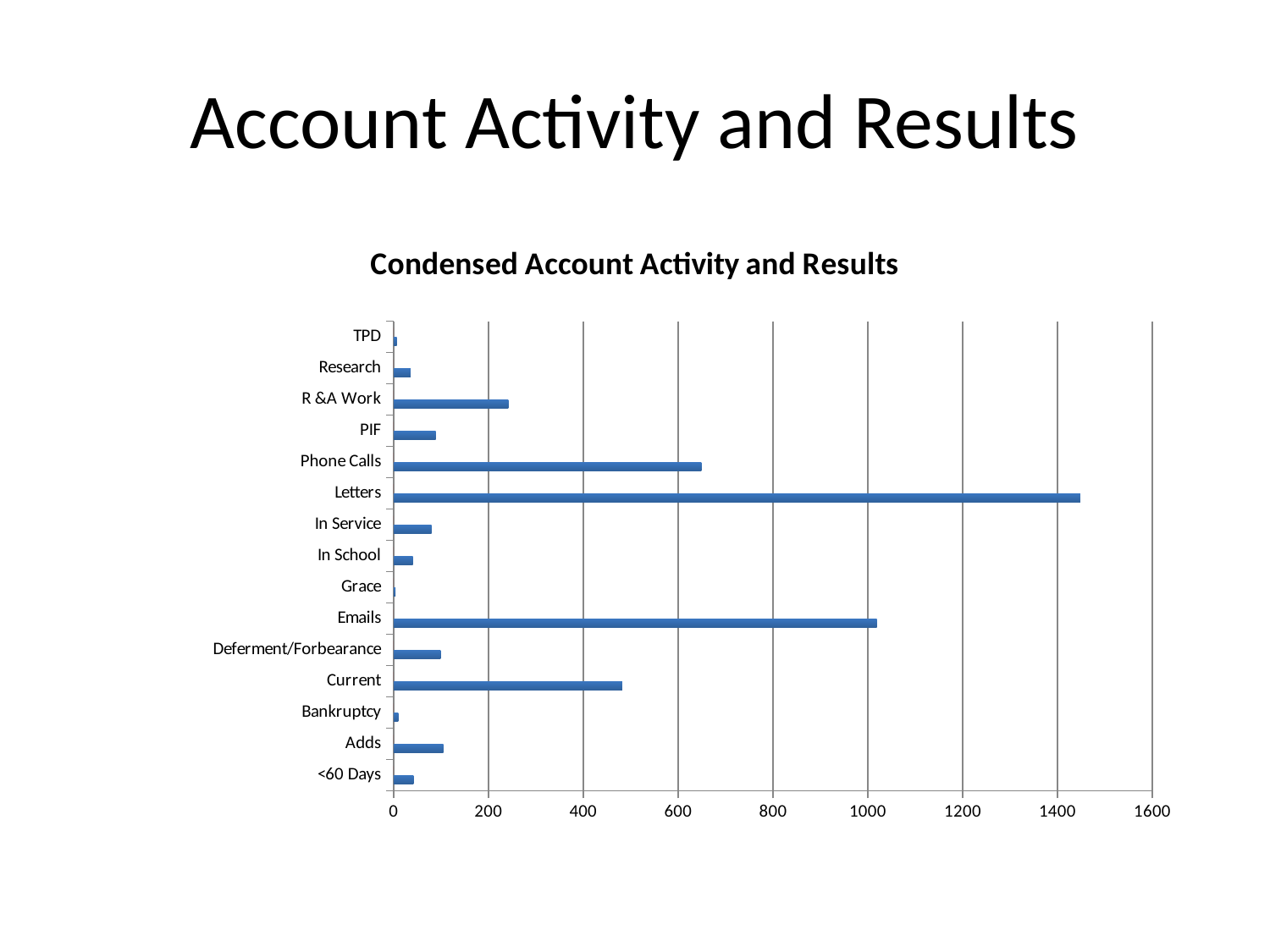
Which is larger, the value for Current or the value for R &A Work? Current Is the value for Emails greater or less than 800? greater Is the value for R &A Work greater or less than 200? greater Is the value for Current greater or less than 400? greater Which is larger, the value for Emails or the value for Phone Calls? Emails What is the title of the chart? Condensed Account Activity and Results Which category has the highest value? Letters How many categories are plotted on the chart? 15 What kind of chart is shown on the slide? bar chart